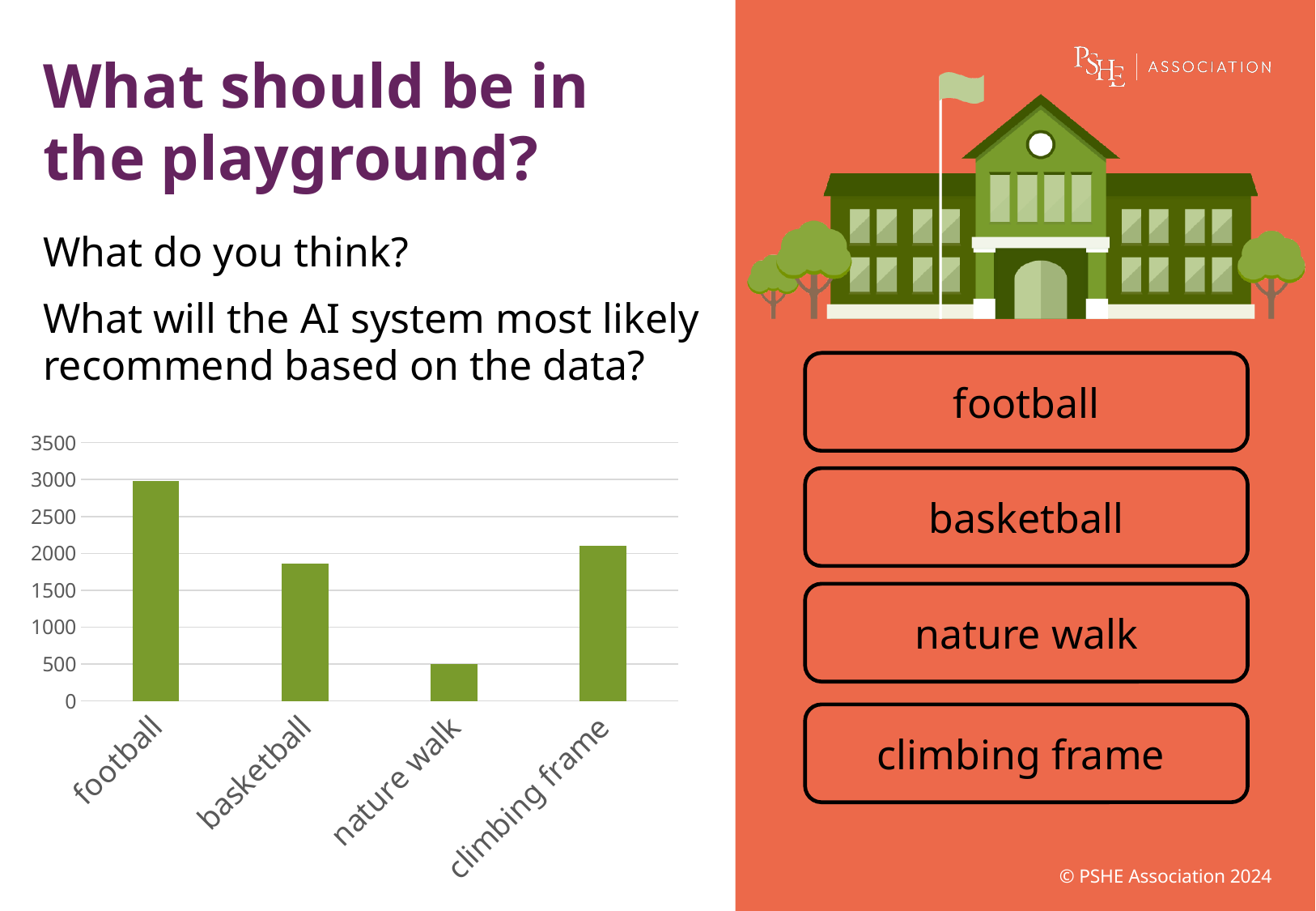
Is the value for climbing frame greater or less than 2000? greater What is the highest value shown on the chart's vertical axis? 3500 Is the value for basketball greater or less than 1500? greater Which is larger, the value for basketball or the value for climbing frame? climbing frame What kind of chart is shown on the slide? bar chart Is the value for nature walk greater or less than 1000? less Which is larger, the value for football or the value for nature walk? football Which category has the lowest bar in the chart? nature walk How many categories are shown on the x axis of the chart? 4 Which category has the highest bar in the chart? football